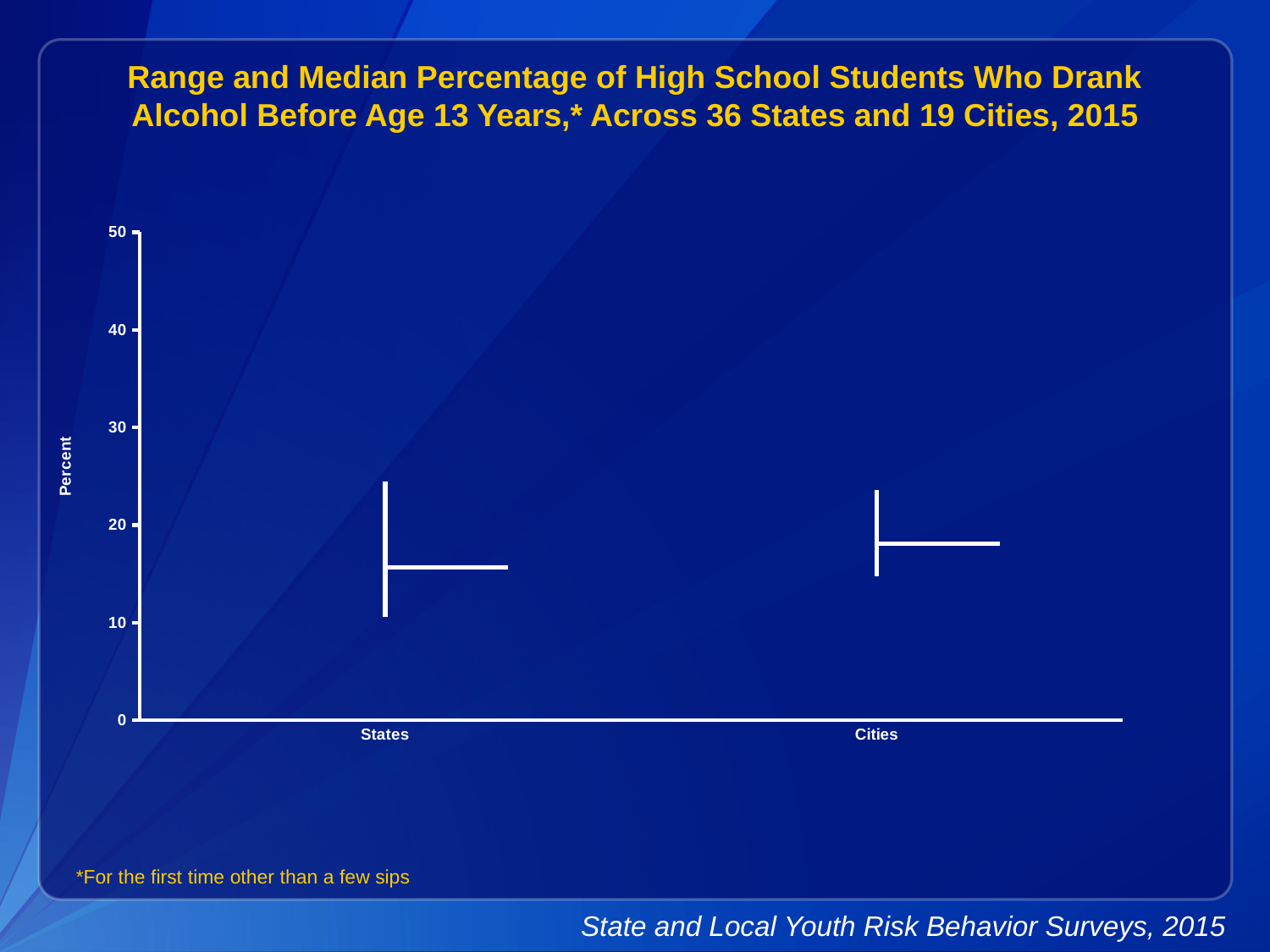
Is the median value for Cities greater or less than 20? less Is the bottom of the range for Cities greater or less than 10? greater Is the top of the range for States greater or less than 20? greater Which category has the lower bottom of its range, States or Cities? States How many categories are shown on the x axis of the chart? 2 What are the two categories shown on the x axis? States and Cities Which category has the higher median value, States or Cities? Cities What is the label of the y axis? Percent